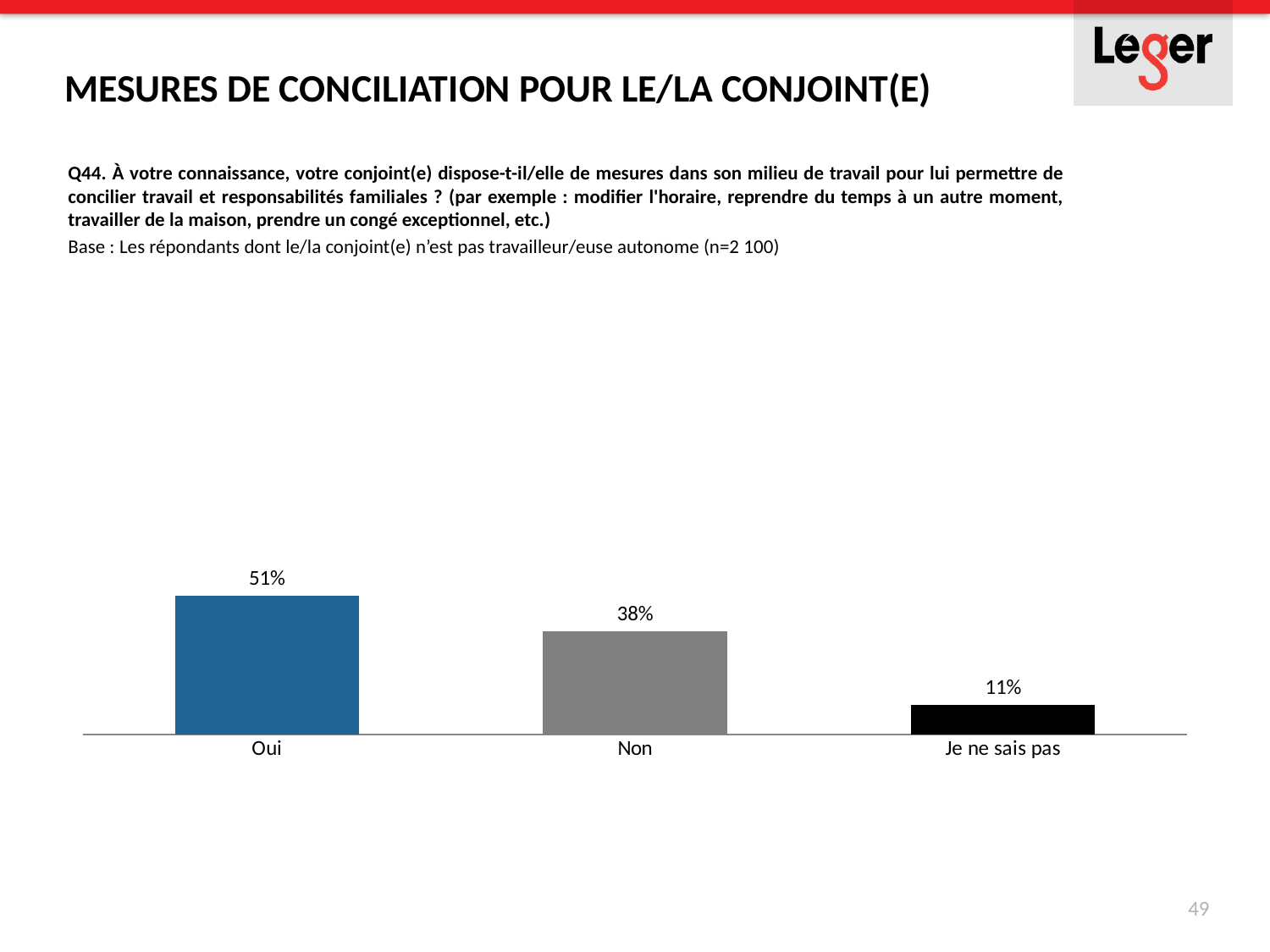
What is the value for Non? 38% What colour is the bar for Oui? Blue Which is larger, the value for Oui or the value for Non? Oui What is the value for Oui? 51% What is the difference between the values for Non and Je ne sais pas? 27% How many categories are shown in the chart? 3 Which category has the highest value? Oui What kind of chart is shown on the slide? Bar chart Do the values rise or fall from left to right across the categories? Fall Which category has the lowest value? Je ne sais pas What is the difference between the values for Oui and Non? 13% What is the value for Je ne sais pas? 11%